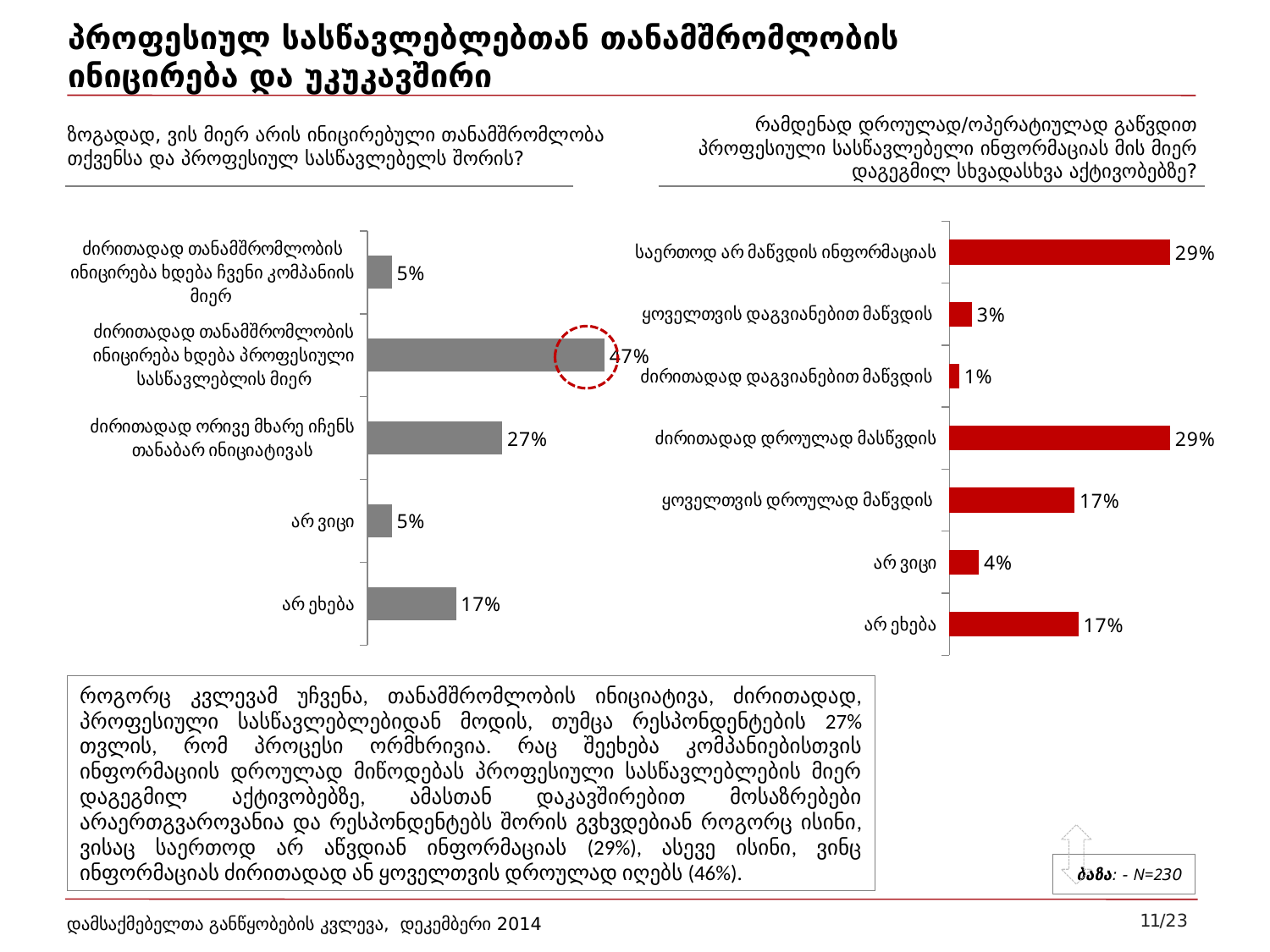
In the left chart, what is the value for "ძირითადად თანამშრომლობის ინიცირება ხდება პროფესიული სასწავლებლის მიერ"? 47% What colour are the bars in the left chart? Grey In the left chart, what is the difference between the values for "ძირითადად თანამშრომლობის ინიცირება ხდება პროფესიული სასწავლებლის მიერ" and "ძირითადად ორივე მხარე იჩენს თანაბარ ინიციატივას"? 20% In the right chart, what is the value for "ყოველთვის დროულად მაწვდის"? 17% In the left chart, how many categories are plotted? 5 What type of chart is the right chart? Bar chart In the right chart, which category has the lowest value? ძირითადად დაგვიანებით მაწვდის In the right chart, which is larger: the value for "ყოველთვის დაგვიანებით მაწვდის" or the value for "არ ვიცი"? არ ვიცი In the right chart, how many categories are plotted? 7 In the right chart, what is the value for "საერთოდ არ მაწვდის ინფორმაციას"? 29% In the left chart, which category has the highest value? ძირითადად თანამშრომლობის ინიცირება ხდება პროფესიული სასწავლებლის მიერ In the left chart, what is the value for "ძირითადად ორივე მხარე იჩენს თანაბარ ინიციატივას"? 27%